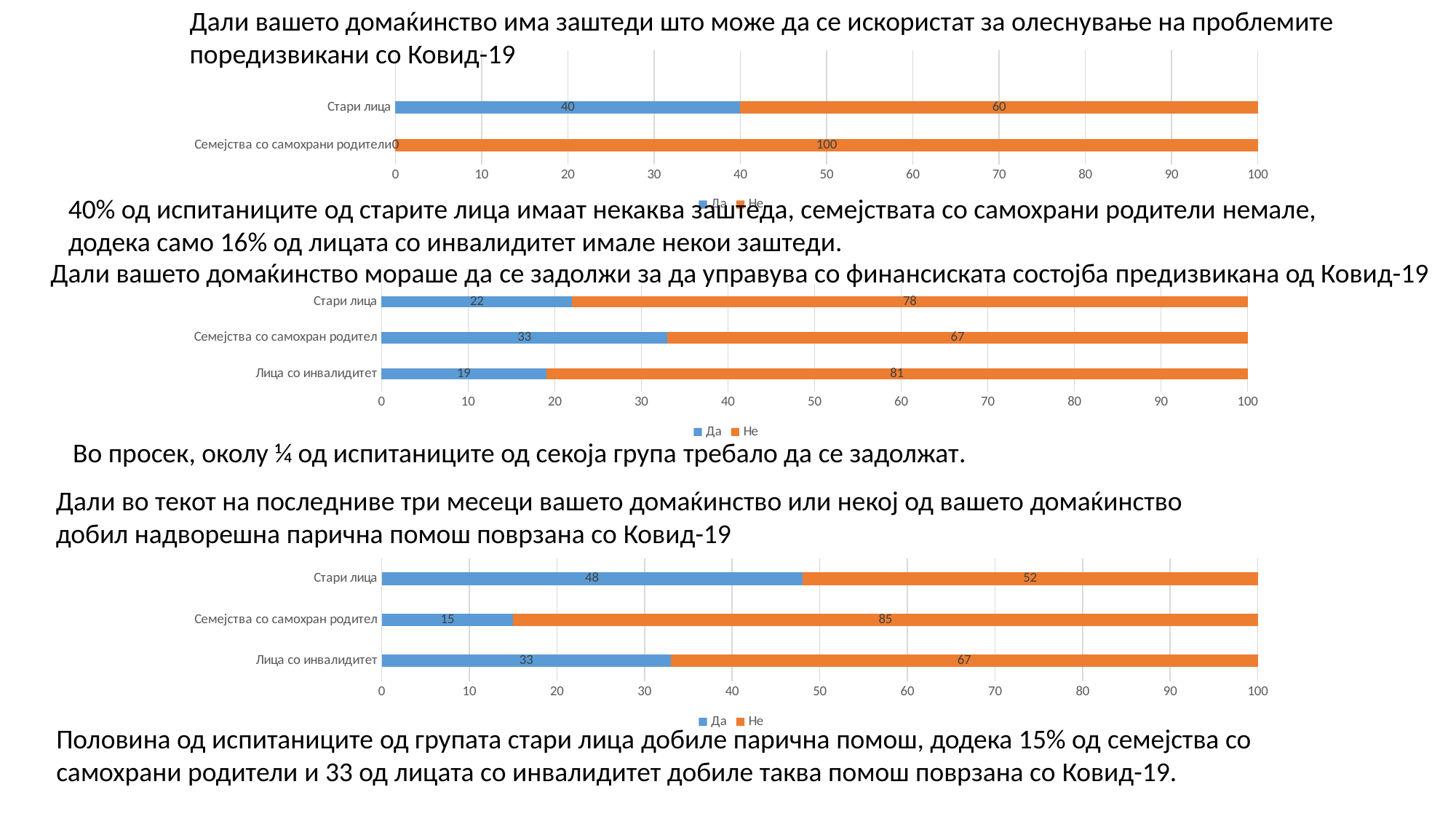
In the middle chart, what is the difference between the 'Не' values for 'Лица со инвалидитет' and 'Стари лица'? 3 What type of chart is the middle chart? Stacked bar chart In the middle chart, what is the value of the 'Да' series for 'Семејства со самохран родител'? 33 In the top chart, what is the value of the 'Не' series for 'Семејства со самохрани родители'? 100 In the bottom chart, what is the value of the 'Не' series for 'Семејства со самохран родител'? 85 In the middle chart, how many categories are shown on the vertical axis? 3 In the bottom chart, which category has the highest 'Да' value? Стари лица In the middle chart, which category has the lowest 'Да' value? Лица со инвалидитет How many series does the legend of the bottom chart list? 2 In the bottom chart, is the 'Да' value for 'Стари лица' larger or smaller than the 'Да' value for 'Лица со инвалидитет'? larger In the top chart, what is the value of the 'Да' series for 'Стари лица'? 40 In the top chart, how many categories are shown on the vertical axis? 2